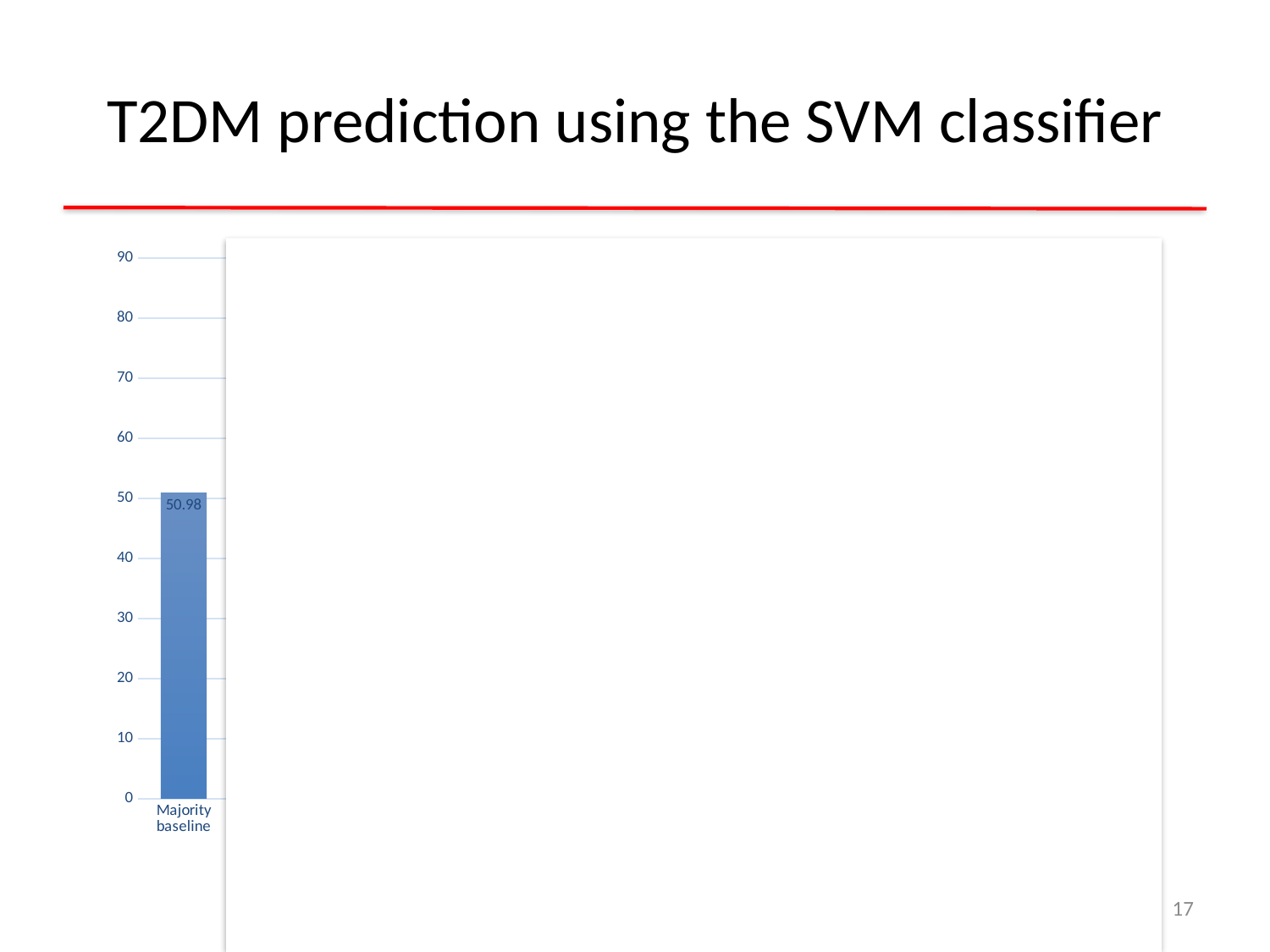
What is the value shown for Majority baseline? 50.98 Is the value for Majority baseline greater or less than 40? greater What kind of chart is shown on the slide? bar chart What is the highest tick value shown on the vertical axis? 90 What is the title of the slide containing the chart? T2DM prediction using the SVM classifier Is the value for Majority baseline greater or less than 60? less What is the label of the category plotted on the chart? Majority baseline How many bars are plotted on the chart? 1